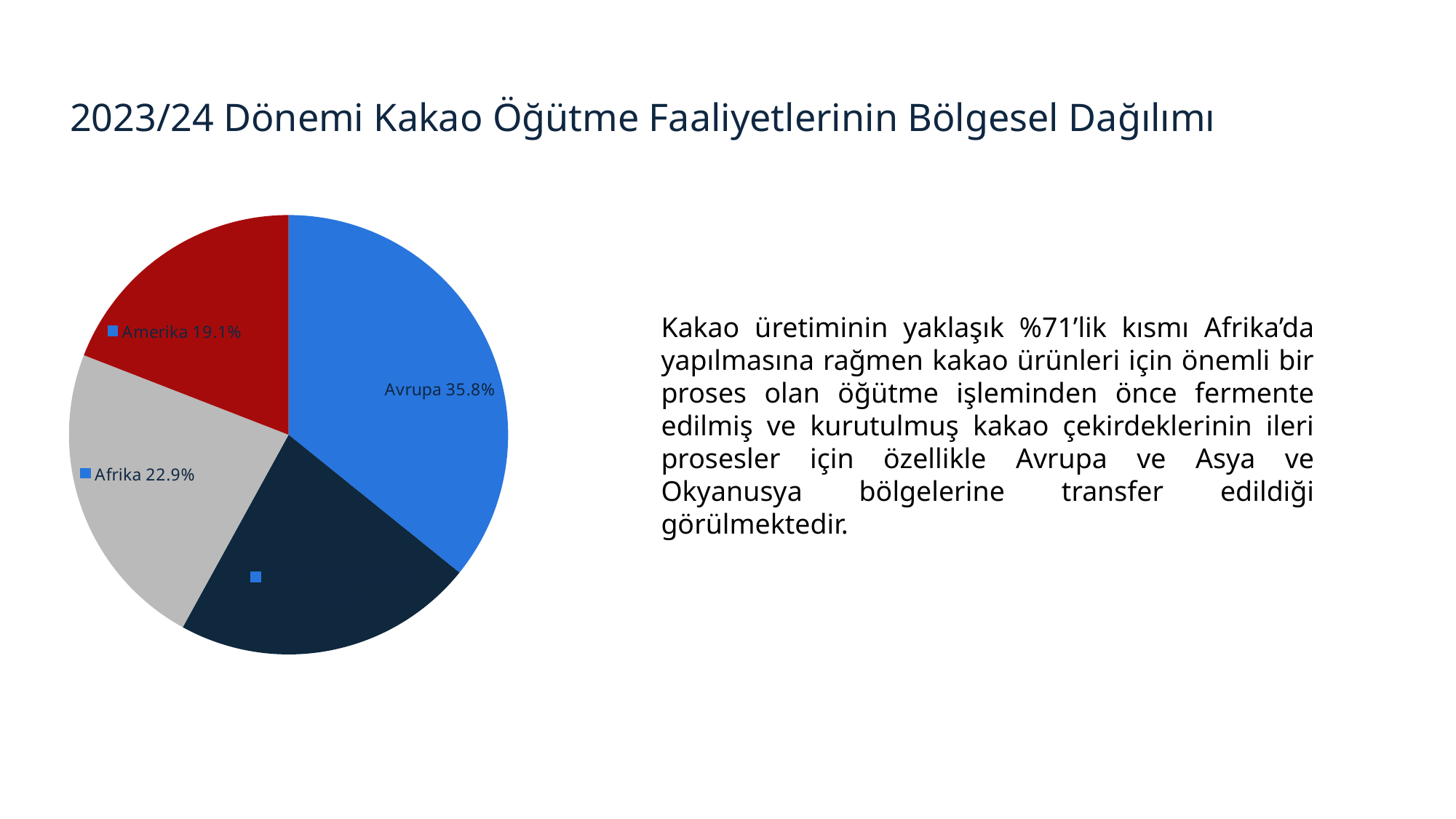
What is the difference in percentage points between the Afrika share and the Amerika share? 3.8 How many slices does the pie chart have? 4 What is the difference in percentage points between the Avrupa share and the Afrika share? 12.9 What share of the pie does Afrika have? 22.9% Which region has the largest slice of the pie? Avrupa What colour is the Amerika slice of the pie chart? Red What type of chart is shown on the slide? Pie chart What share of the pie does Amerika have? 19.1% What is the title of the slide containing the pie chart? 2023/24 Dönemi Kakao Öğütme Faaliyetlerinin Bölgesel Dağılımı Which is larger, the share for Afrika or the share for Amerika? Afrika What share of the pie does Avrupa have? 35.8% Which is larger, the share for Avrupa or the share for Afrika? Avrupa